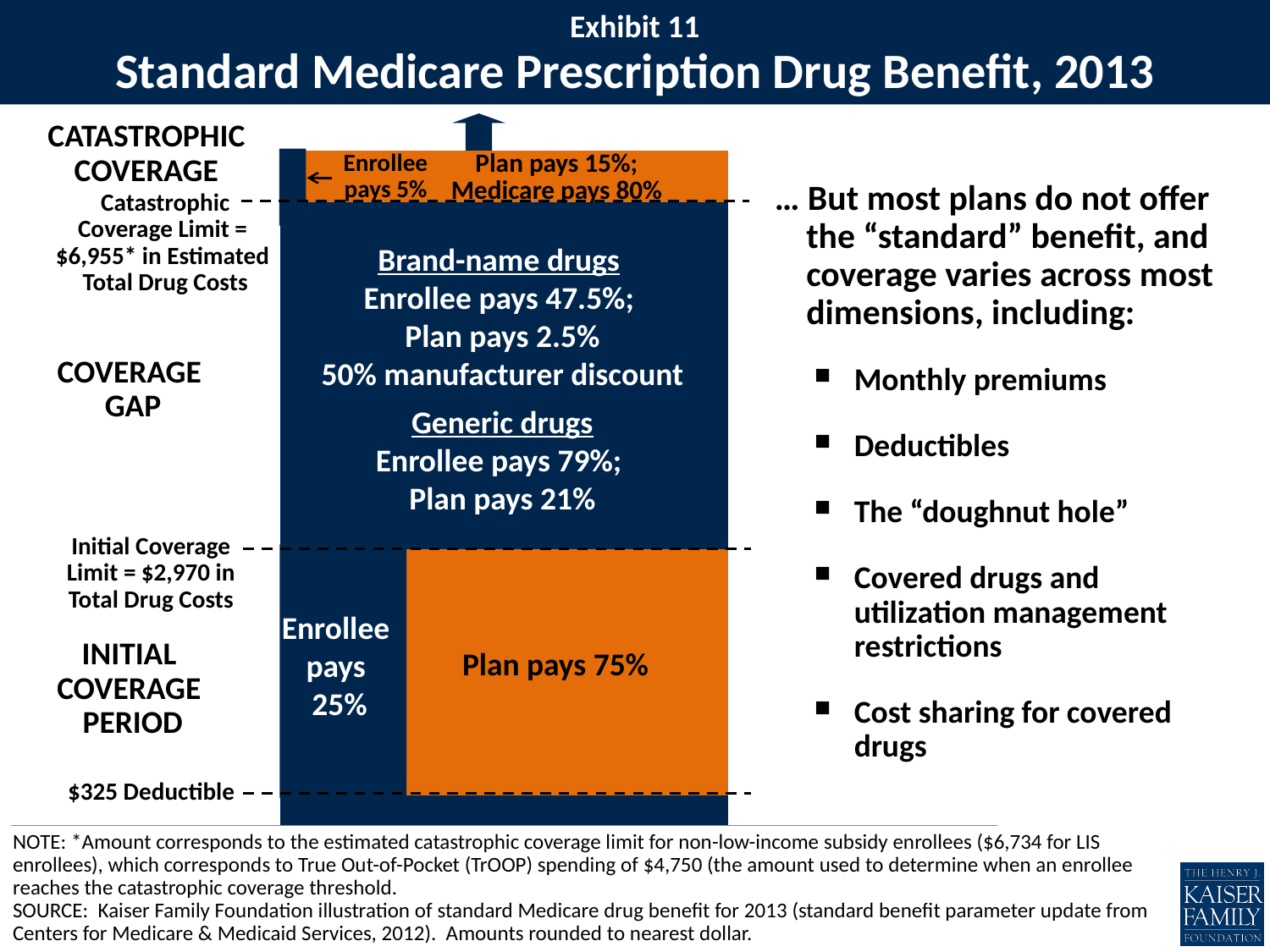
What is the title of the slide's diagram? Standard Medicare Prescription Drug Benefit, 2013 What is the catastrophic coverage limit in estimated total drug costs? $6,955 In the coverage gap, what percentage does the plan pay for generic drugs? 21% In the coverage gap, what percentage does the enrollee pay for generic drugs? 79% What is the deductible amount shown at the bottom of the diagram? $325 What is the initial coverage limit in total drug costs? $2,970 In the initial coverage period, what percentage does the plan pay? 75% In the initial coverage period, what percentage does the enrollee pay? 25% Which is larger in the coverage gap: the enrollee's share for generic drugs or for brand-name drugs? Generic drugs In the coverage gap, what percentage does the enrollee pay for brand-name drugs? 47.5% In catastrophic coverage, what percentage does Medicare pay? 80% In catastrophic coverage, what percentage does the enrollee pay? 5%